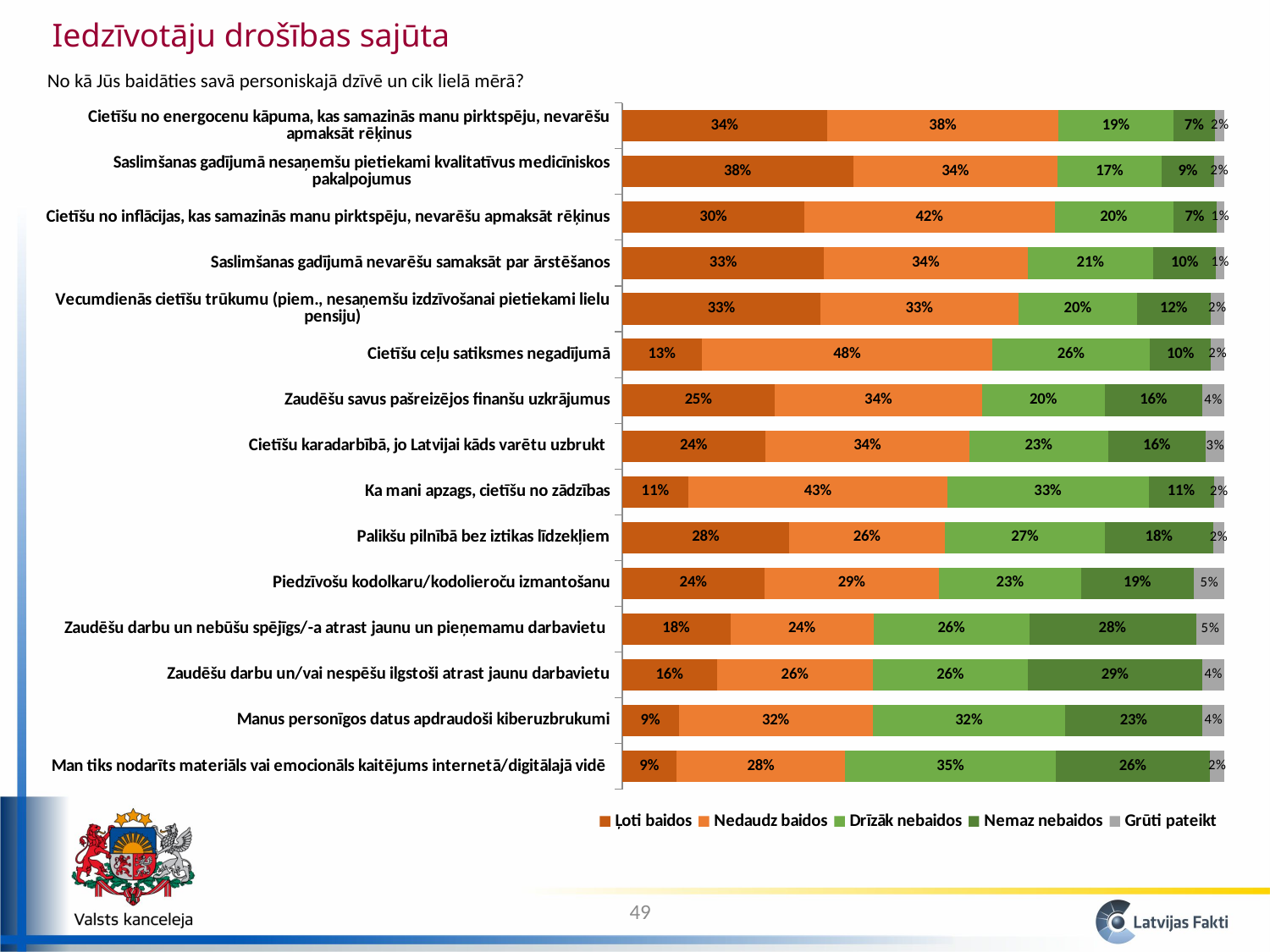
What is the 'Nemaz nebaidos' value for 'Zaudēšu darbu un/vai nespēšu ilgstoši atrast jaunu darbavietu'? 29% What is the difference between the 'Ļoti baidos' values for 'Cietīšu no energocenu kāpuma...' and 'Cietīšu no inflācijas...'? 4 percentage points Which is larger: the 'Nemaz nebaidos' value for 'Piedzīvošu kodolkaru/kodolieroču izmantošanu' or for 'Ka mani apzags, cietīšu no zādzības'? Piedzīvošu kodolkaru/kodolieroču izmantošanu Which statement has the highest 'Nedaudz baidos' share? Cietīšu ceļu satiksmes negadījumā What is the total of the stacked bar for 'Cietīšu no energocenu kāpuma, kas samazinās manu pirktspēju, nevarēšu apmaksāt rēķinus'? 100% What is the 'Ļoti baidos' value for 'Cietīšu ceļu satiksmes negadījumā'? 13% How many categories (statements) are plotted in the chart? 15 Which statement has the highest 'Drīzāk nebaidos' share? Man tiks nodarīts materiāls vai emocionāls kaitējums internetā/digitālajā vidē What is the 'Nedaudz baidos' value for 'Cietīšu no inflācijas, kas samazinās manu pirktspēju, nevarēšu apmaksāt rēķinus'? 42% What kind of chart is shown on the slide? Stacked bar chart How many series does the legend list? 5 Which statement has the highest 'Ļoti baidos' share? Saslimšanas gadījumā nesaņemšu pietiekami kvalitatīvus medicīniskos pakalpojumus